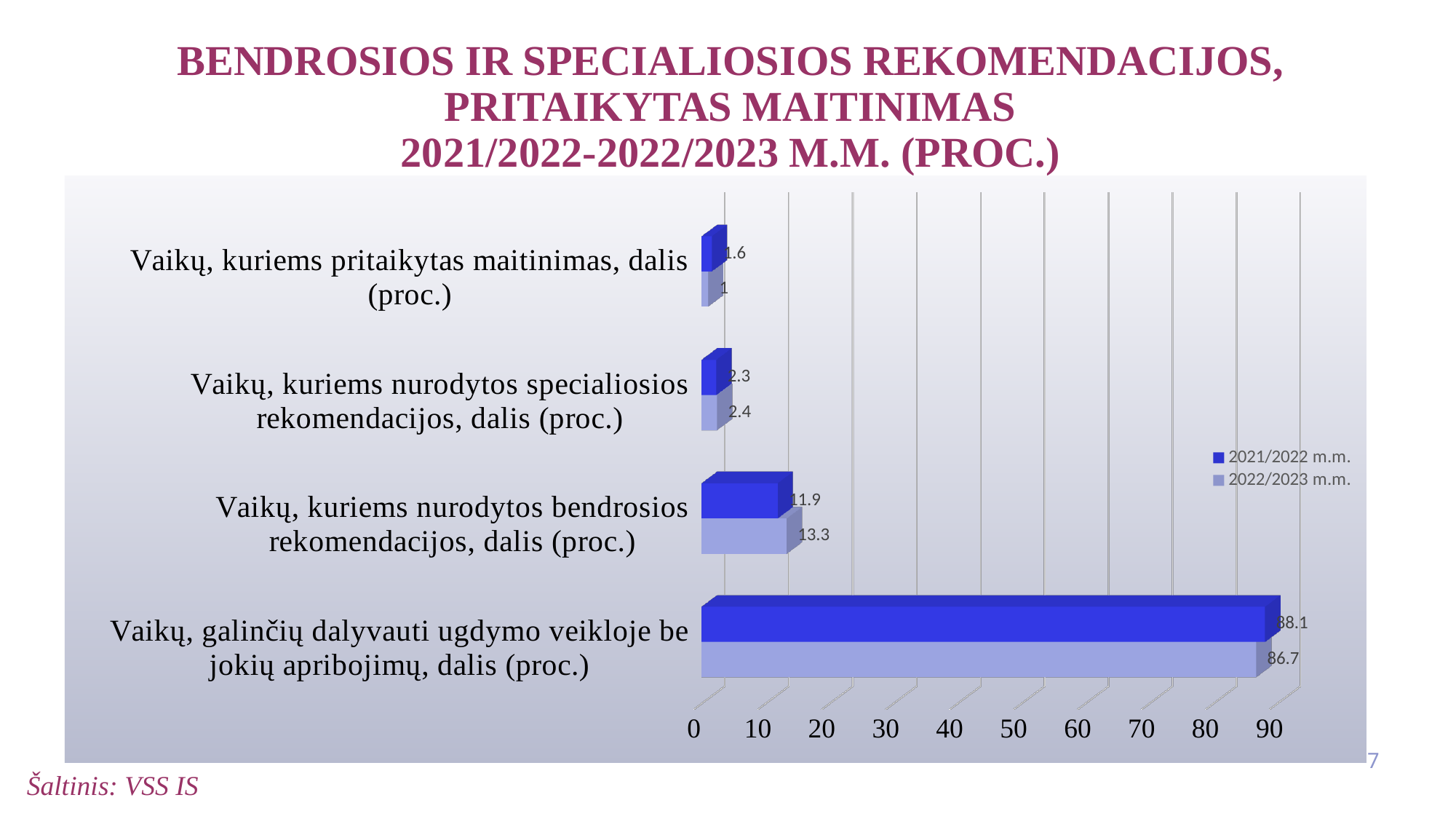
Which category has the highest value in the 2022/2023 m.m. series? Vaikų, galinčių dalyvauti ugdymo veikloje be jokių apribojimų, dalis (proc.) Which category has the lowest value in the 2021/2022 m.m. series? Vaikų, kuriems pritaikytas maitinimas, dalis (proc.) For 'Vaikų, kuriems nurodytos bendrosios rekomendacijos, dalis (proc.)', which series has the larger value, 2021/2022 m.m. or 2022/2023 m.m.? 2022/2023 m.m. How many series does the legend list? 2 How many categories are shown on the chart? 4 What is the value for 'Vaikų, kuriems nurodytos specialiosios rekomendacijos, dalis (proc.)' in the 2021/2022 m.m. series? 2.3 What is the value for 'Vaikų, kuriems pritaikytas maitinimas, dalis (proc.)' in the 2022/2023 m.m. series? 1 What is the value for 'Vaikų, kuriems nurodytos bendrosios rekomendacijos, dalis (proc.)' in the 2022/2023 m.m. series? 13.3 What is the value for 'Vaikų, galinčių dalyvauti ugdymo veikloje be jokių apribojimų, dalis (proc.)' in the 2021/2022 m.m. series? 88.1 Is the 2021/2022 m.m. value for 'Vaikų, galinčių dalyvauti ugdymo veikloje be jokių apribojimų, dalis (proc.)' greater or less than 80? greater What is the difference between the 2021/2022 m.m. and 2022/2023 m.m. values for 'Vaikų, galinčių dalyvauti ugdymo veikloje be jokių apribojimų, dalis (proc.)'? 1.4 What kind of chart is shown on the slide? Bar chart